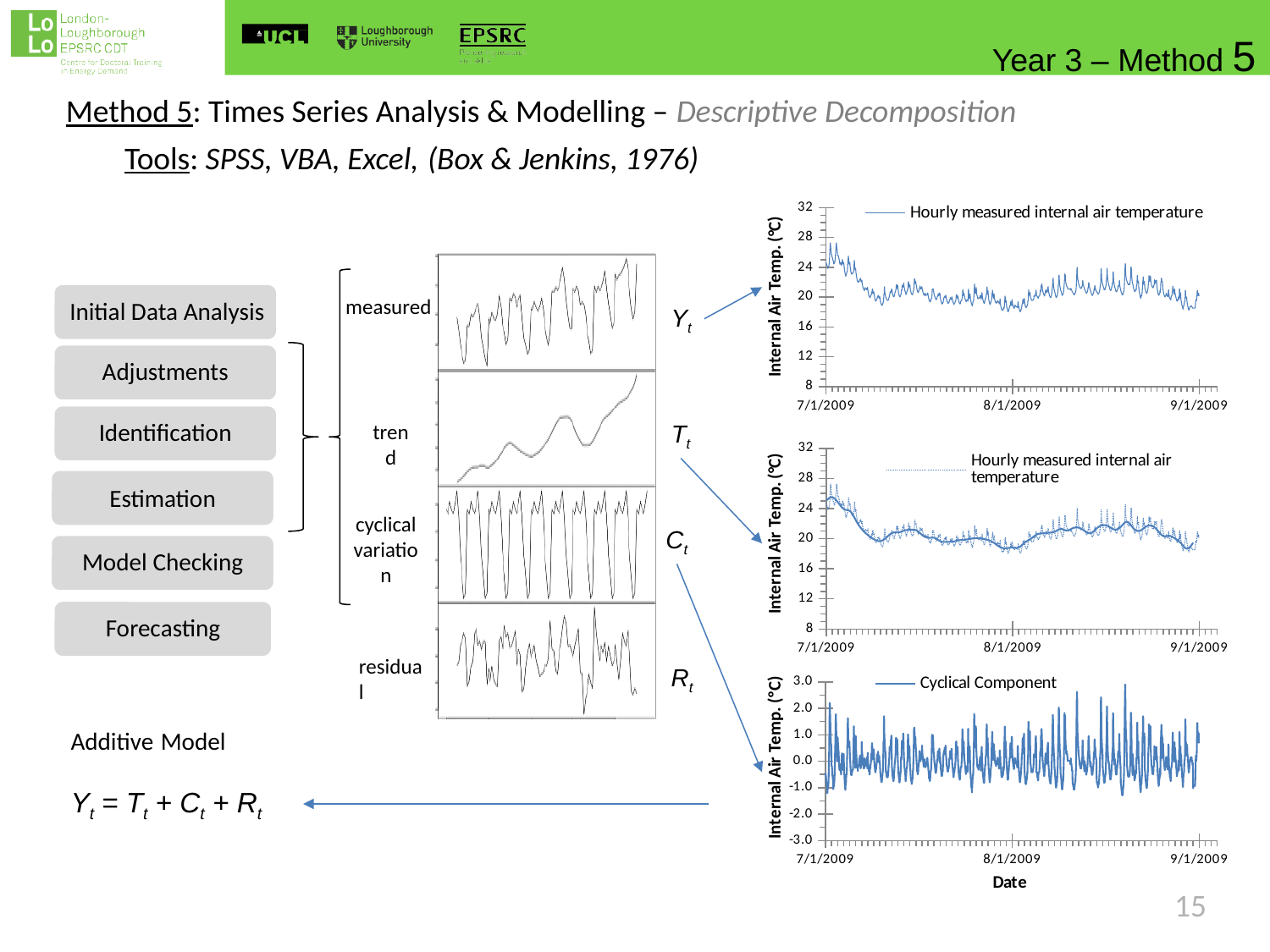
In the top chart, is the internal air temperature at 7/1/2009 greater or less than 28? less In the middle chart, is the internal air temperature at 9/1/2009 greater or less than 28? less In the bottom chart, what is the x-axis title? Date In the bottom chart, is the highest value of the Cyclical Component greater or less than 2.0? greater In the bottom chart, what is the legend entry? Cyclical Component In the top chart, how many series does the legend list? 1 What kind of chart is the top chart titled 'Hourly measured internal air temperature'? line chart What kind of chart is the bottom chart titled 'Cyclical Component'? line chart In the top chart, does the internal air temperature rise or fall between 7/1/2009 and 8/1/2009? fall